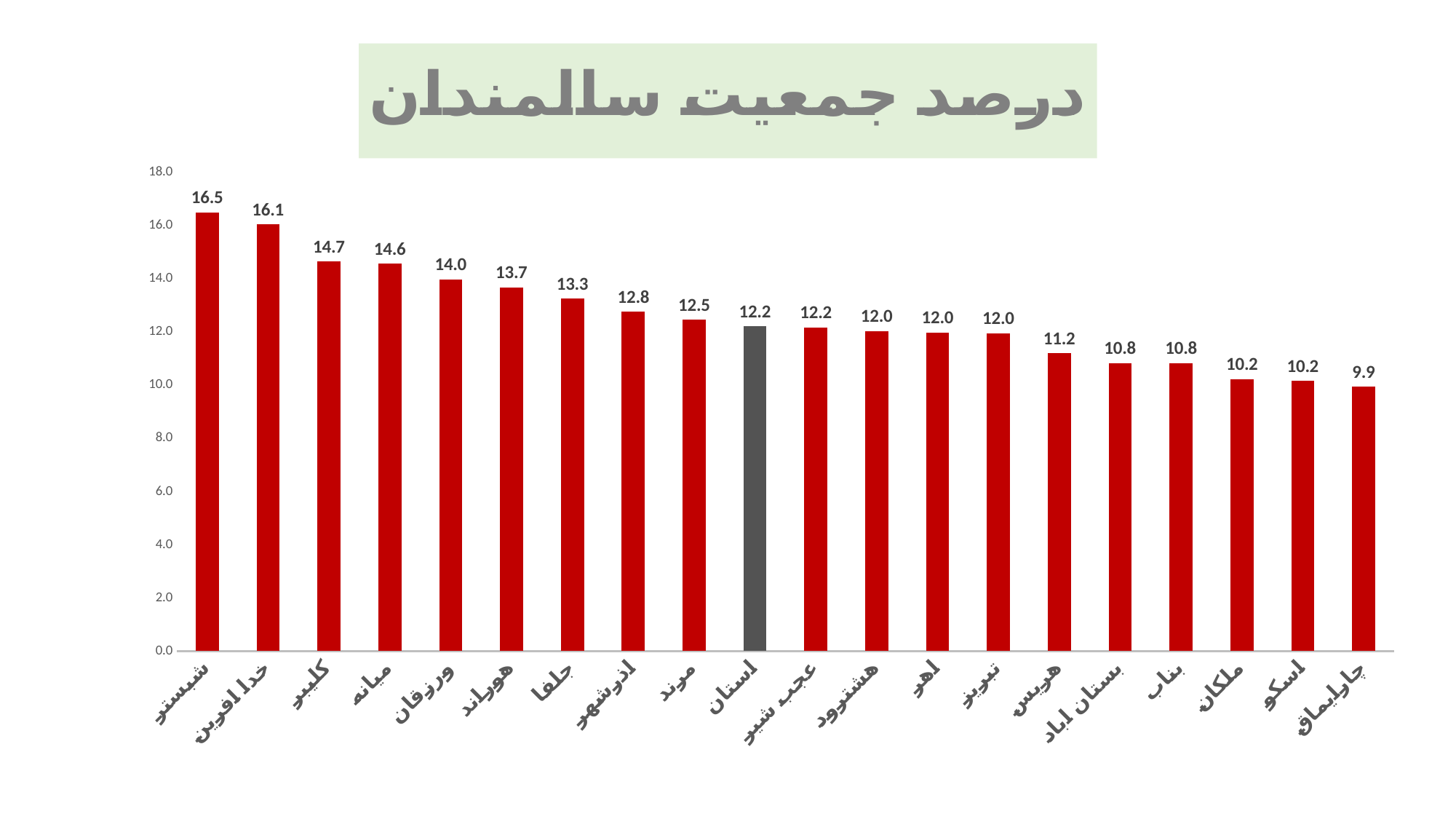
What kind of chart is shown on the slide? Bar chart What is the value for the gray bar labelled استان? 12.2 What is the difference between the values for کلیبر and هریس? 3.5 Which is larger, the value for جلفا or the value for مرند? جلفا What is the title of the chart? درصد جمعیت سالمندان What is the value for تبریز? 12.0 How many bars are shown in the chart? 20 Which category has the lowest value? چارایماق What is the difference between the values for شبستر and چاراویماق? 6.6 What is the value for شبستر? 16.5 Is the value for خدا آفرین greater or less than 14.0? greater Which category has the highest value? شبستر